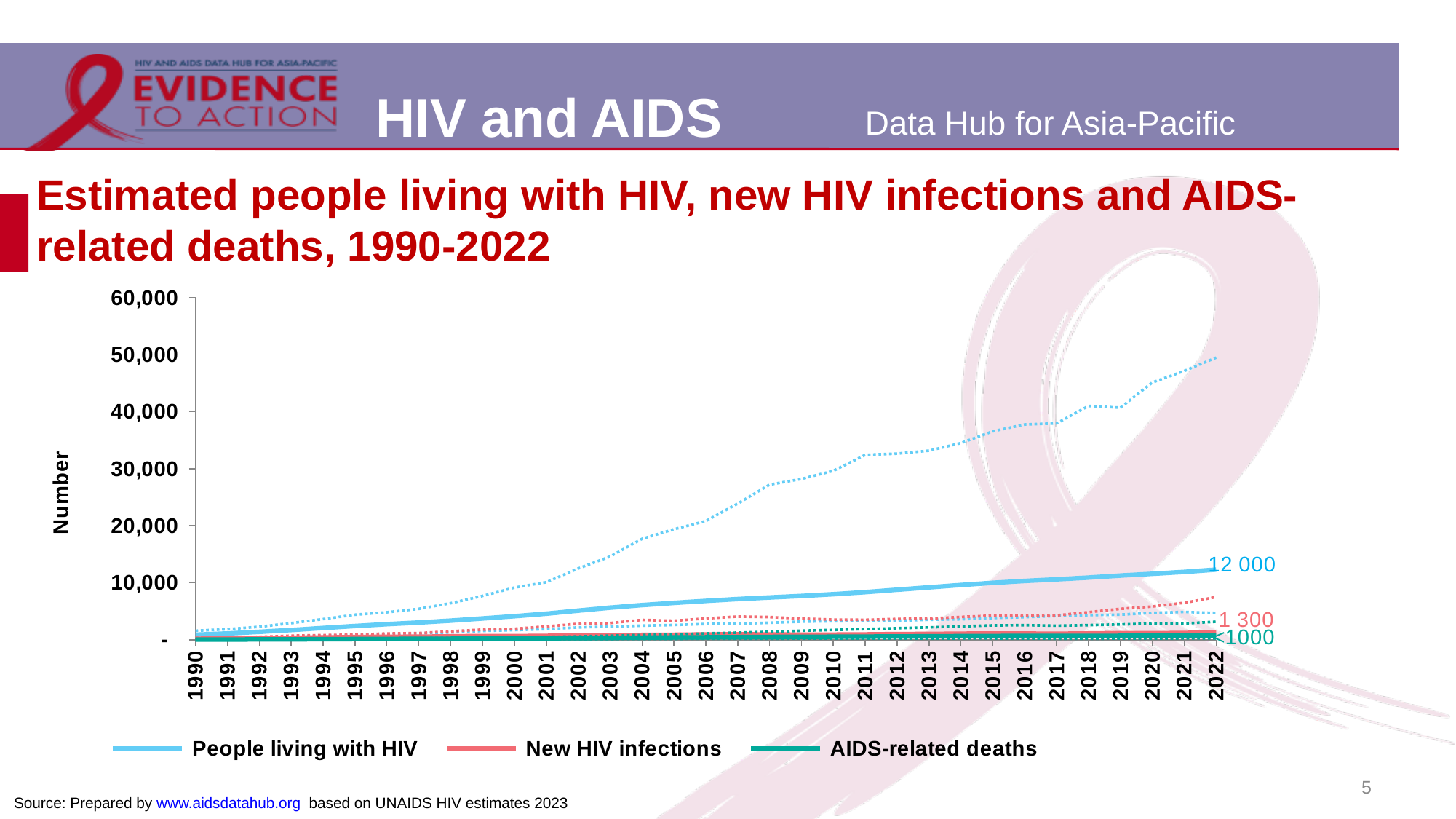
What is the value for AIDS-related deaths in 2022? <1000 How many series does the legend list? 3 Does the People living with HIV line rise or fall from 1990 to 2022? Rises What is the difference between People living with HIV and New HIV infections in 2022? 10 700 What kind of chart is shown on the slide? Line chart In 2022, which is larger: People living with HIV or New HIV infections? People living with HIV What is the label on the y axis? Number What is the value for People living with HIV in 2022? 12 000 What is the value for New HIV infections in 2022? 1 300 Which series has the lowest value in 2022? AIDS-related deaths How many years are shown on the x axis? 33 Is the value for People living with HIV in 2010 greater or less than 10,000? less